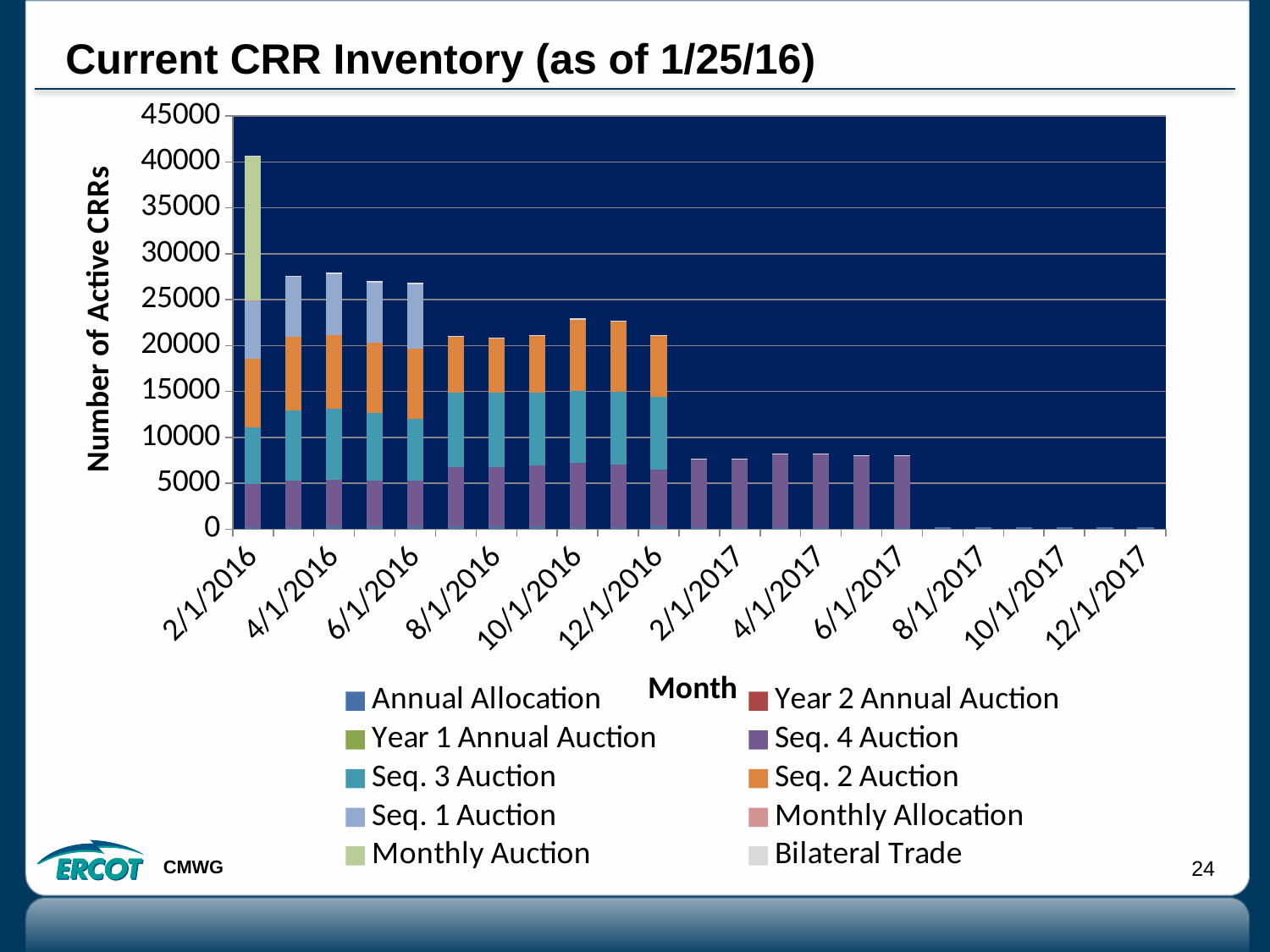
Do the total values generally rise or fall from 2/1/2016 to 12/1/2017? fall Is the total value for 4/1/2016 greater or less than 25000? greater What is the label of the y axis? Number of Active CRRs What kind of chart is shown on the slide? Stacked bar chart Is the total value for 2/1/2017 greater or less than 10000? less Which month has the highest total number of active CRRs? 2/1/2016 Which has a larger total, 12/1/2016 or 2/1/2017? 12/1/2016 Is the total value for 6/1/2017 greater or less than 5000? greater How many series does the legend list? 10 What is the title of the chart? Current CRR Inventory (as of 1/25/16) Which has a larger total, 2/1/2016 or 4/1/2016? 2/1/2016